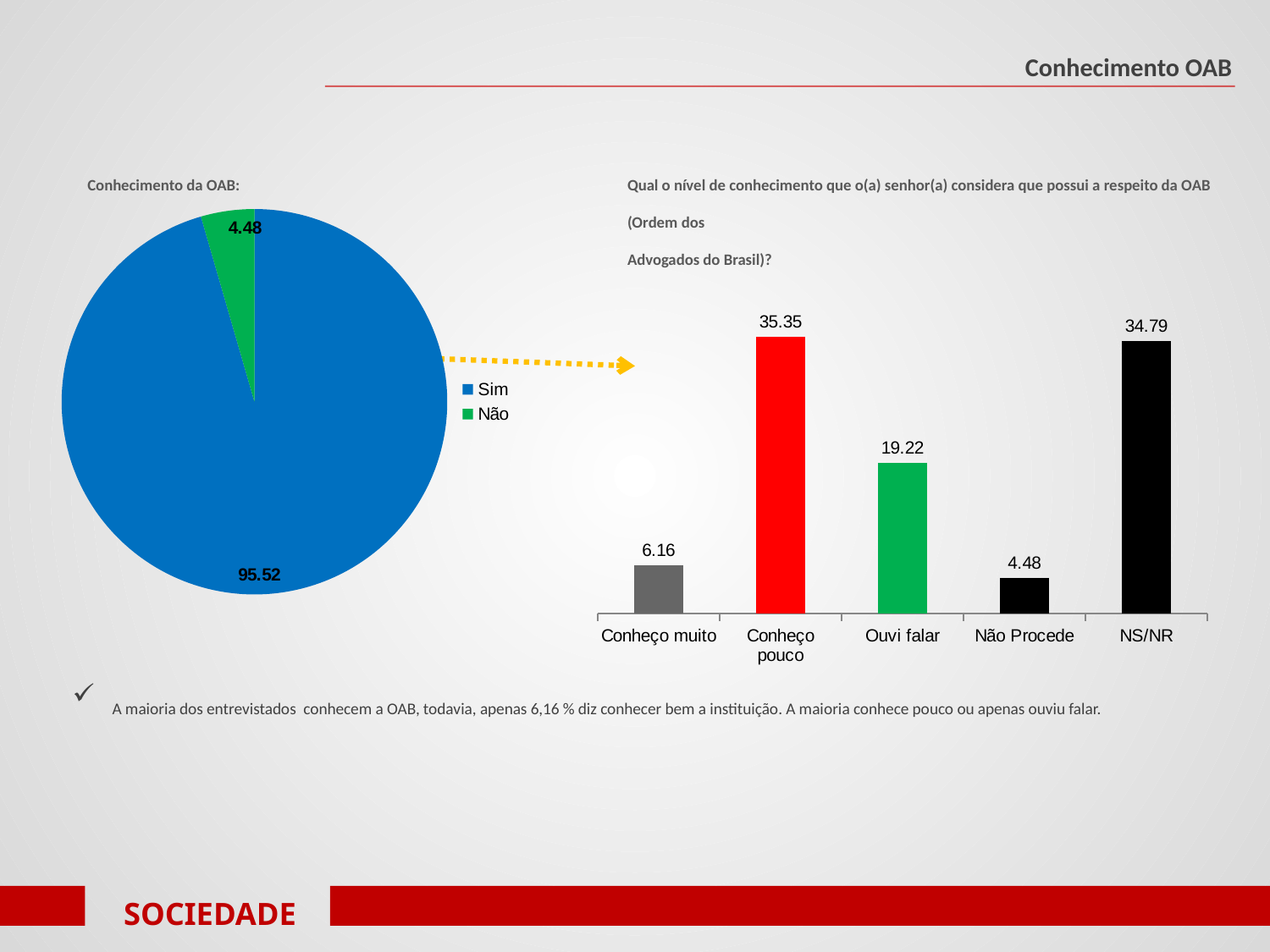
In the pie chart titled 'Conhecimento da OAB:', what is the value for 'Sim'? 95.52 What kind of chart is the chart on the left of the slide? Pie chart In the bar chart on the right, what is the value for 'NS/NR'? 34.79 In the bar chart on the right, which category has the lowest value? Não Procede In the bar chart on the right, what is the difference between 'Conheço pouco' and 'Conheço muito'? 29.19 In the pie chart titled 'Conhecimento da OAB:', what is the value for 'Não'? 4.48 In the pie chart on the left, which slice is larger, 'Sim' or 'Não'? Sim In the bar chart on the right, what is the value for 'Ouvi falar'? 19.22 In the bar chart on the right, which category has the highest value? Conheço pouco In the bar chart on the right, what is the value for 'Conheço pouco'? 35.35 In the bar chart on the right, how many categories are shown on the x axis? 5 In the pie chart on the left, how many slices are there? 2